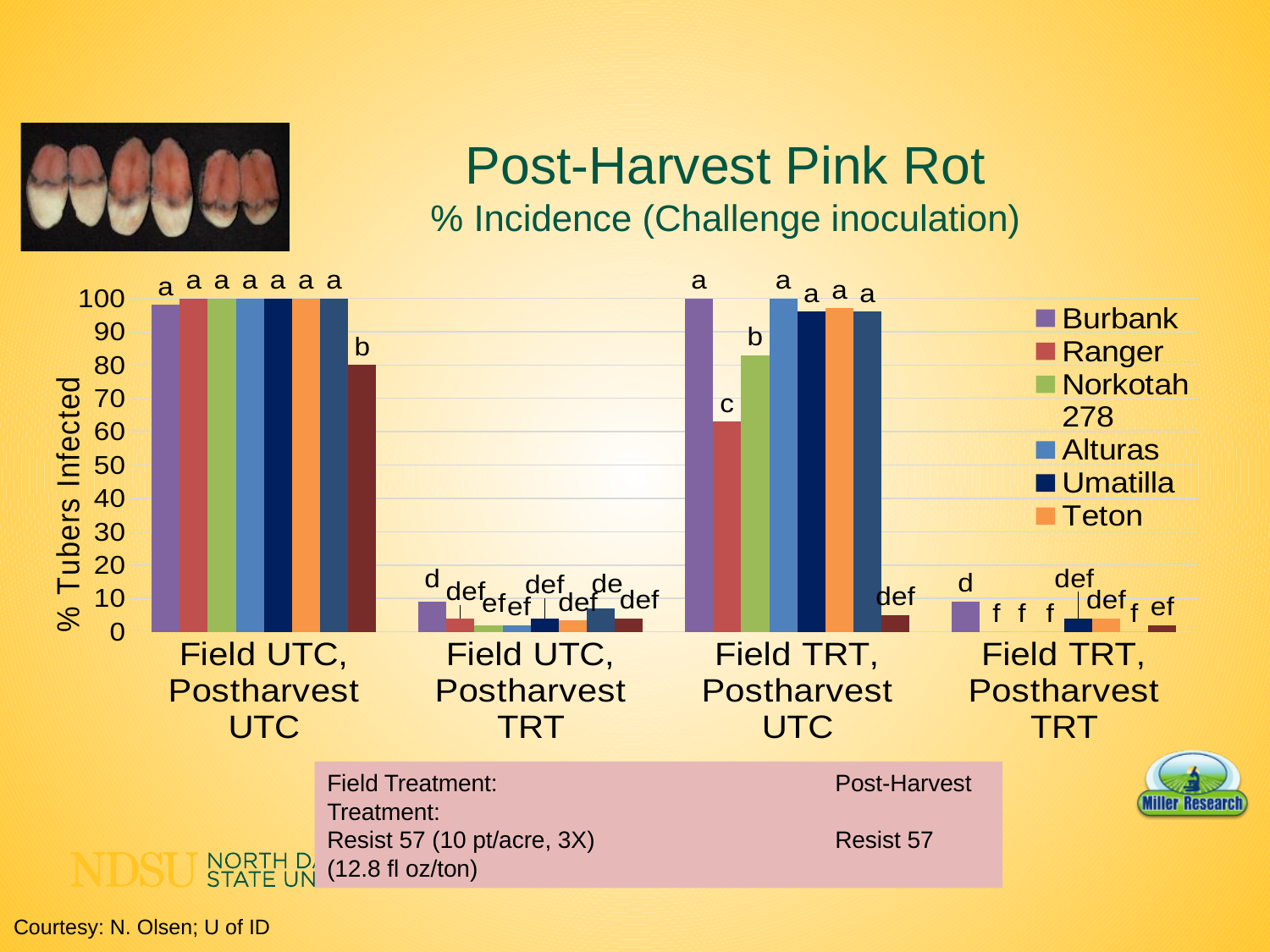
Is the value for Teton in the Field UTC, Postharvest TRT group greater or less than 10? less What is the label on the y axis? % Tubers Infected What letter is printed above the Ranger bar in the Field TRT, Postharvest UTC group? c Is the value for Norkotah 278 in the Field TRT, Postharvest UTC group greater or less than 70? greater How many series does the legend list? 6 What kind of chart is shown on the slide? bar chart Is the value for Ranger in the Field TRT, Postharvest UTC group greater or less than 50? greater For Norkotah 278, which is larger: the Field UTC, Postharvest UTC value or the Field UTC, Postharvest TRT value? Field UTC, Postharvest UTC In the Field TRT, Postharvest UTC group, which is larger: Burbank or Ranger? Burbank How many treatment categories are shown along the x axis? 4